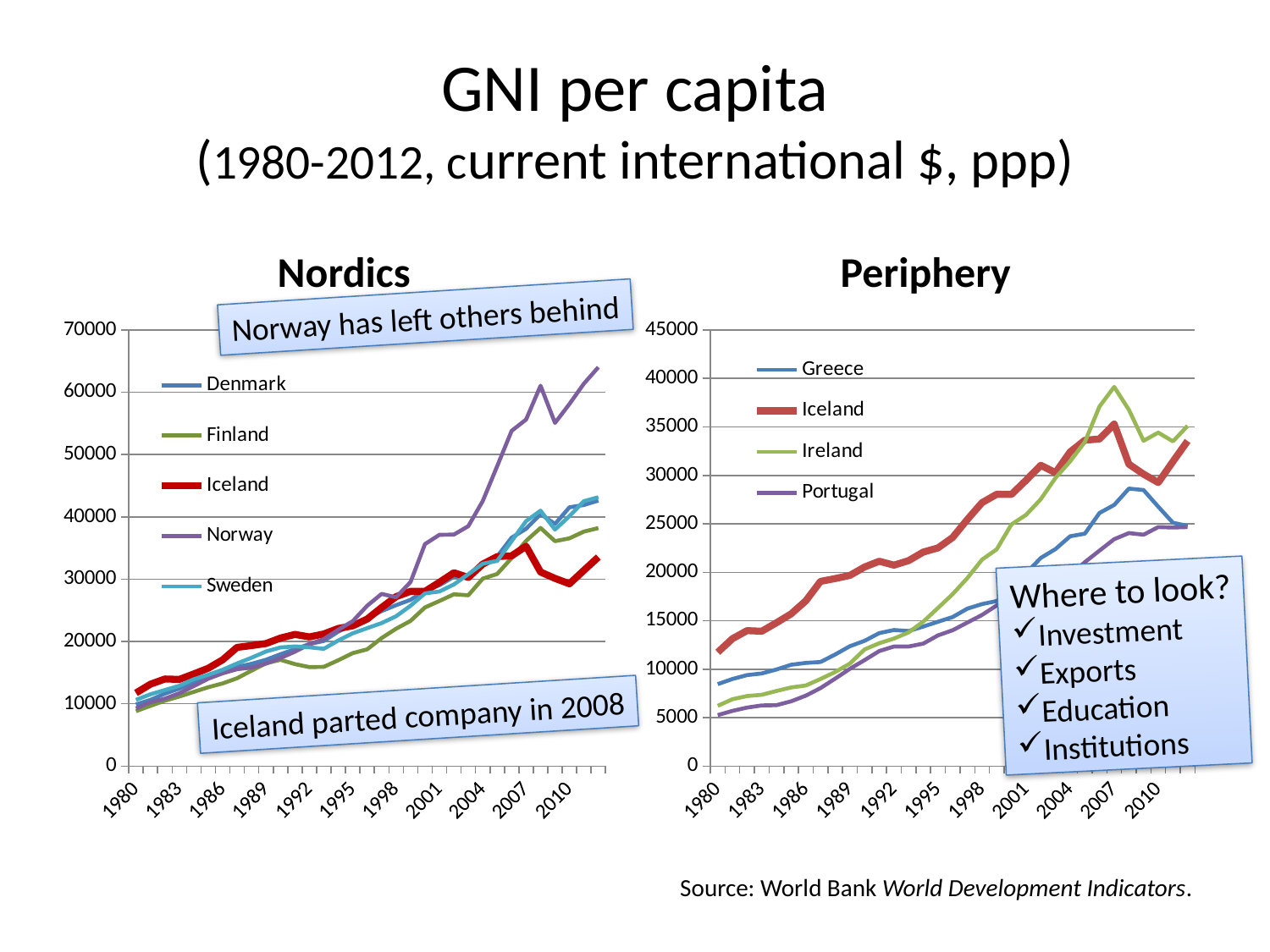
In the Nordics chart, is the value for Iceland in 2012 greater or less than 40000? less In the Periphery chart, is the value for Portugal in 1980 greater or less than 10000? less Which country appears in the legends of both the Nordics chart and the Periphery chart? Iceland How many series does the legend of the Periphery chart list? 4 What kind of chart is the Nordics chart? line chart How many series does the legend of the Nordics chart list? 5 In the Periphery chart, is the value for Ireland in 2007 greater or less than 35000? greater In the Nordics chart, which country has the lowest GNI per capita in 2012? Iceland In the Nordics chart, which country has the highest GNI per capita in 2012? Norway In the Nordics chart, does the Norway line generally rise or fall from 1980 to 2012? rise In the Periphery chart, which country has the highest GNI per capita in 1980? Iceland